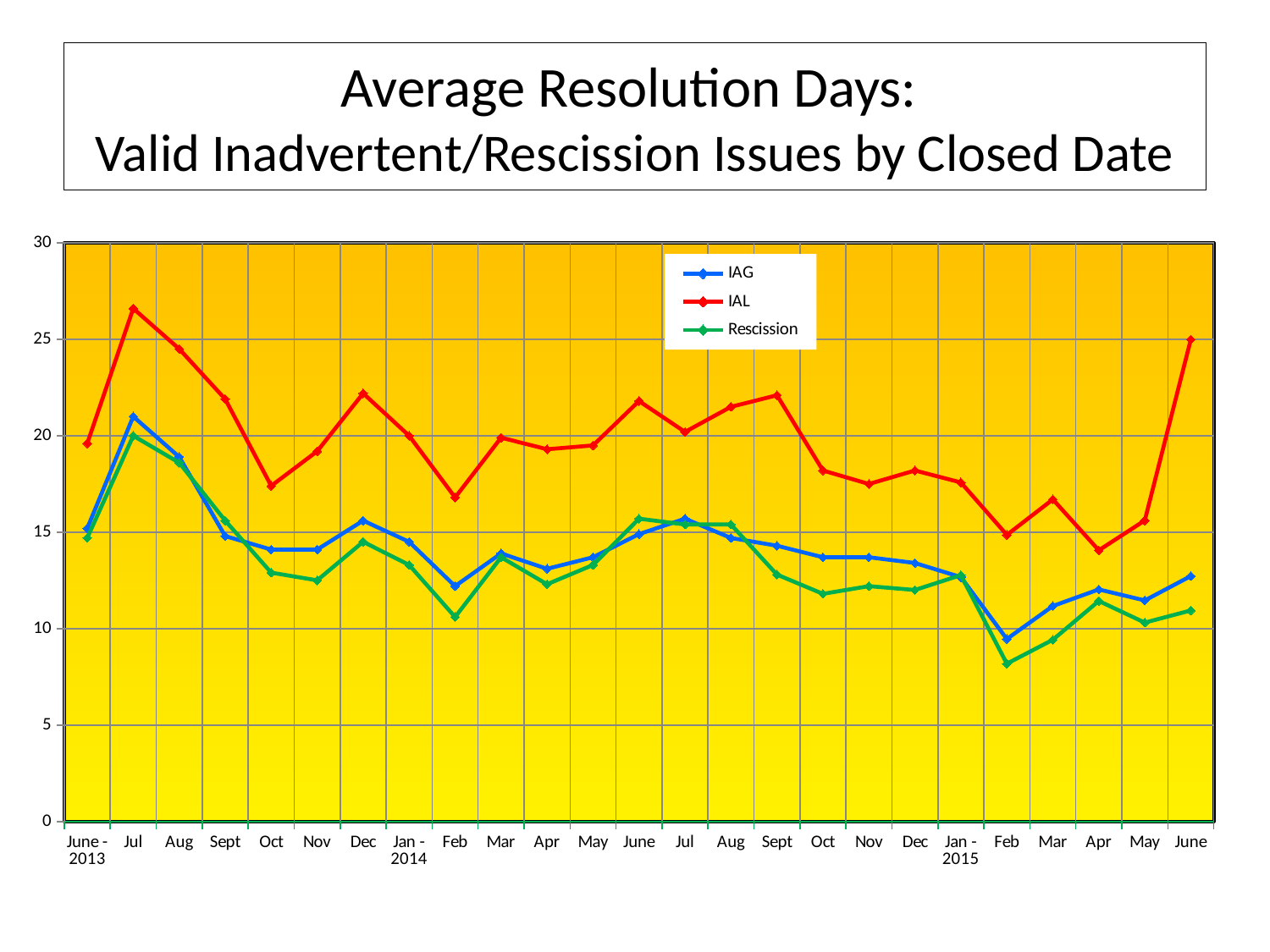
In which month does the IAG series reach its lowest value? Feb 2015 In which month does the Rescission series reach its lowest value? Feb 2015 Is the IAG value for Feb 2015 greater or less than 10? less In which month does the IAL series reach its highest value? Jul 2013 Is the IAL value for Jul 2013 greater or less than 25? greater Is the IAL value for Oct 2013 greater or less than 20? less How many months (data points) are plotted along the x axis? 25 Which series has the higher value in Jul 2013, IAG or IAL? IAL Does the IAL series rise or fall from Apr 2015 to June 2015? Rise How many series does the legend list? 3 Which series are listed in the legend? IAG, IAL, Rescission What kind of chart is shown on the slide? Line chart